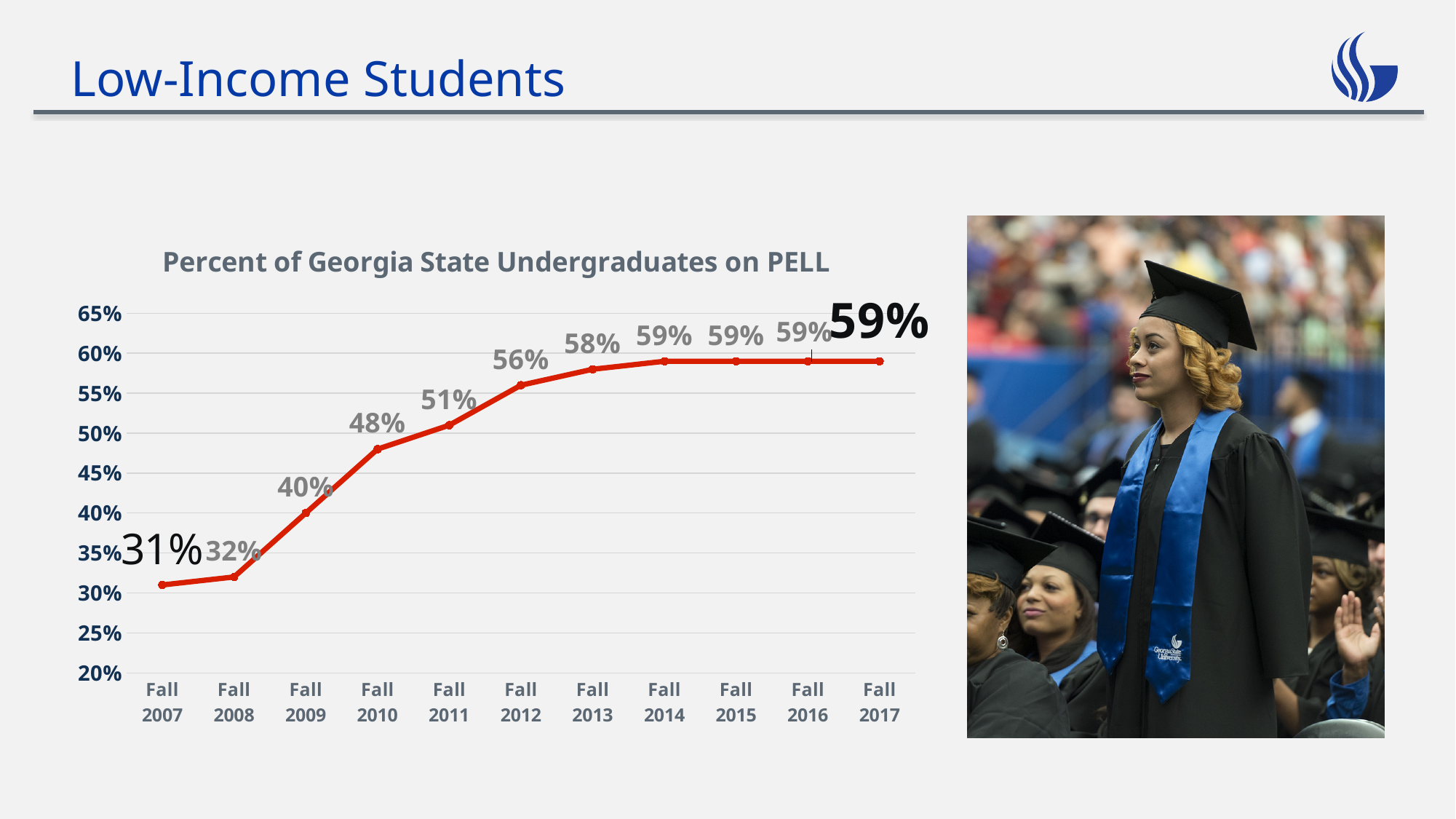
What is the difference between the values for Fall 2017 and Fall 2007? 28% How many data points are plotted on the chart? 11 Is the value for Fall 2009 greater or less than 45%? less Which is larger, the value for Fall 2011 or the value for Fall 2013? Fall 2013 What is the value for Fall 2012? 56% What is the value for Fall 2007? 31% Do the values rise or fall from Fall 2007 to Fall 2014? rise What kind of chart is shown on the slide? line chart What is the value for Fall 2017? 59% What is the difference between the values for Fall 2010 and Fall 2009? 8% What is the value for Fall 2010? 48% Which year has the lowest percent of undergraduates on PELL? Fall 2007